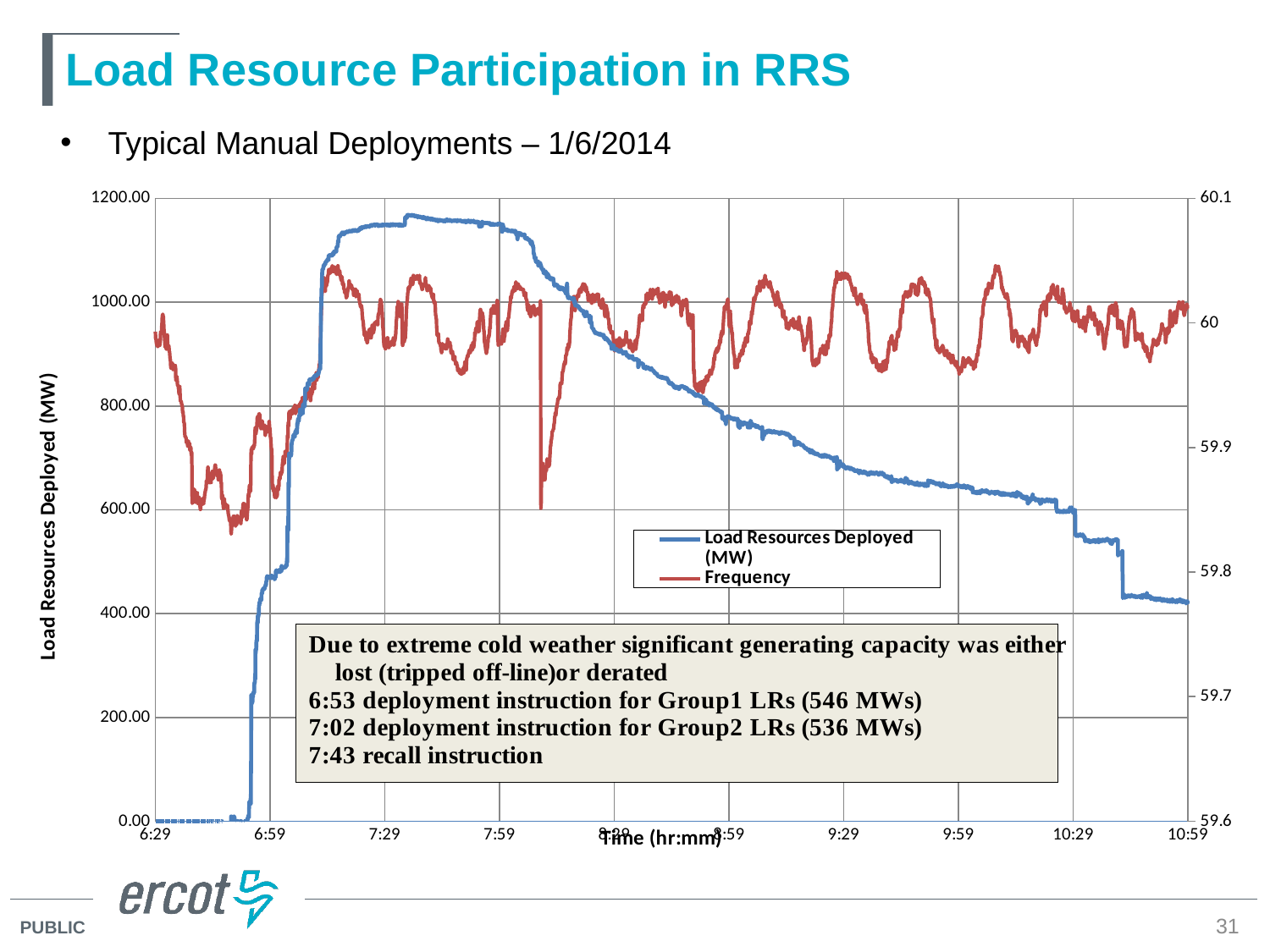
Between 6:59 and 7:29, does the Load Resources Deployed (MW) line rise or fall? rise Is the value of Load Resources Deployed (MW) at 9:29 greater or less than 800? less What is the title of the chart's x axis? Time (hr:mm) Is the value of Load Resources Deployed (MW) at 8:29 greater or less than 1000? less Is the value of Load Resources Deployed (MW) at 10:59 greater or less than 600? less Between 7:59 and 10:59, does the Load Resources Deployed (MW) line rise or fall? fall What are the two series named in the chart's legend? Load Resources Deployed (MW) and Frequency What kind of chart is shown on the slide? line chart How many series does the chart's legend list? 2